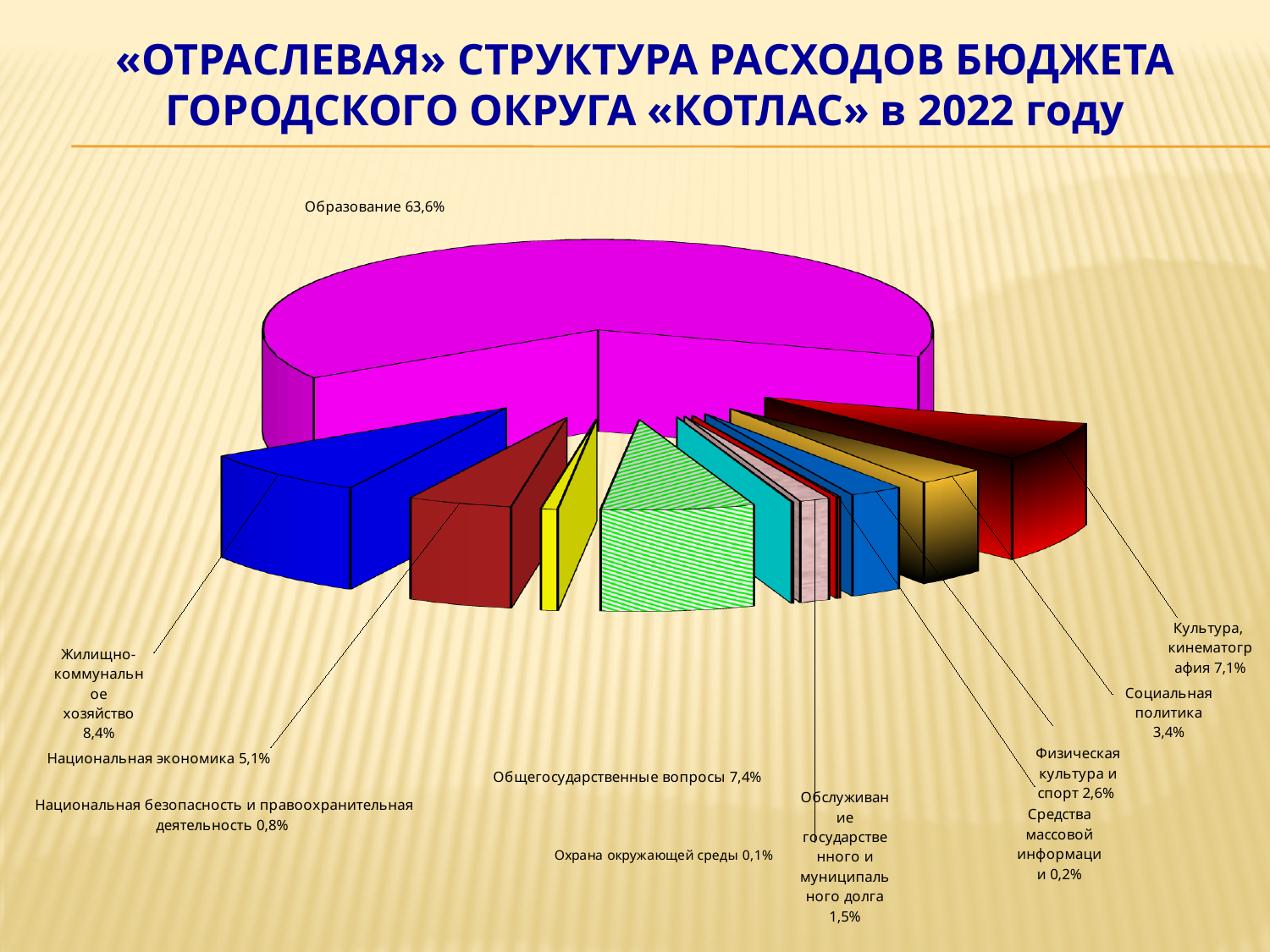
What is the value for Жилищно-коммунальное хозяйство? 8,4% Which year does the chart title refer to? 2022 What percentage is shown for Культура, кинематография? 7,1% What is the difference between the shares of Образование and Жилищно-коммунальное хозяйство? 55,2 percentage points What is the value for Обслуживание государственного и муниципального долга? 1,5% Which category has the largest share of the pie? Образование What is the difference between the shares of Общегосударственные вопросы and Культура, кинематография? 0,3 percentage points How many categories are shown in the pie chart? 11 Which is larger: Национальная экономика or Социальная политика? Национальная экономика Which category has the smallest share of the pie? Охрана окружающей среды What share of budget expenditure goes to Образование? 63,6% What type of chart is shown on the slide? Pie chart